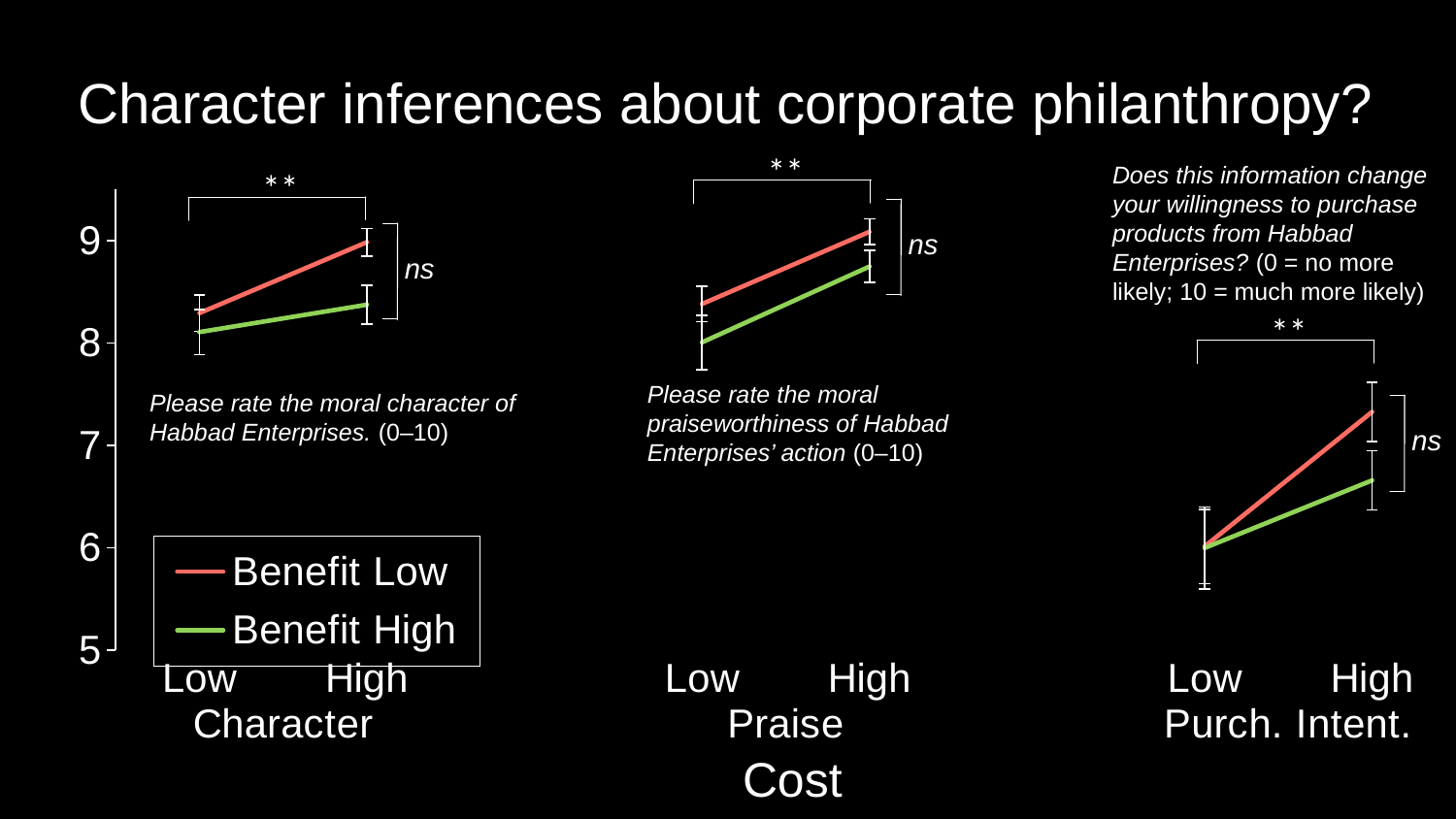
How many series does the legend list? 2 In the Character chart, is the Benefit Low value at Low cost greater or less than 9? less In the Character chart, what label marks the comparison between the Benefit Low and Benefit High lines at High cost? ns In the Character chart, does the Benefit Low line rise or fall from Low to High cost? rise In the Praise chart, does the Benefit High line rise or fall from Low to High cost? rise What are the two series named in the legend? Benefit Low and Benefit High In the Character chart, how many Cost categories are on the x axis? 2 In the Character chart, is the Benefit High value at High cost greater or less than 8? greater In the Character chart, at High cost, which series has the higher value, Benefit Low or Benefit High? Benefit Low What kind of chart is used for the Character panel on the left? line chart In the Purch. Intent. chart, at High cost, which series has the higher value, Benefit Low or Benefit High? Benefit Low